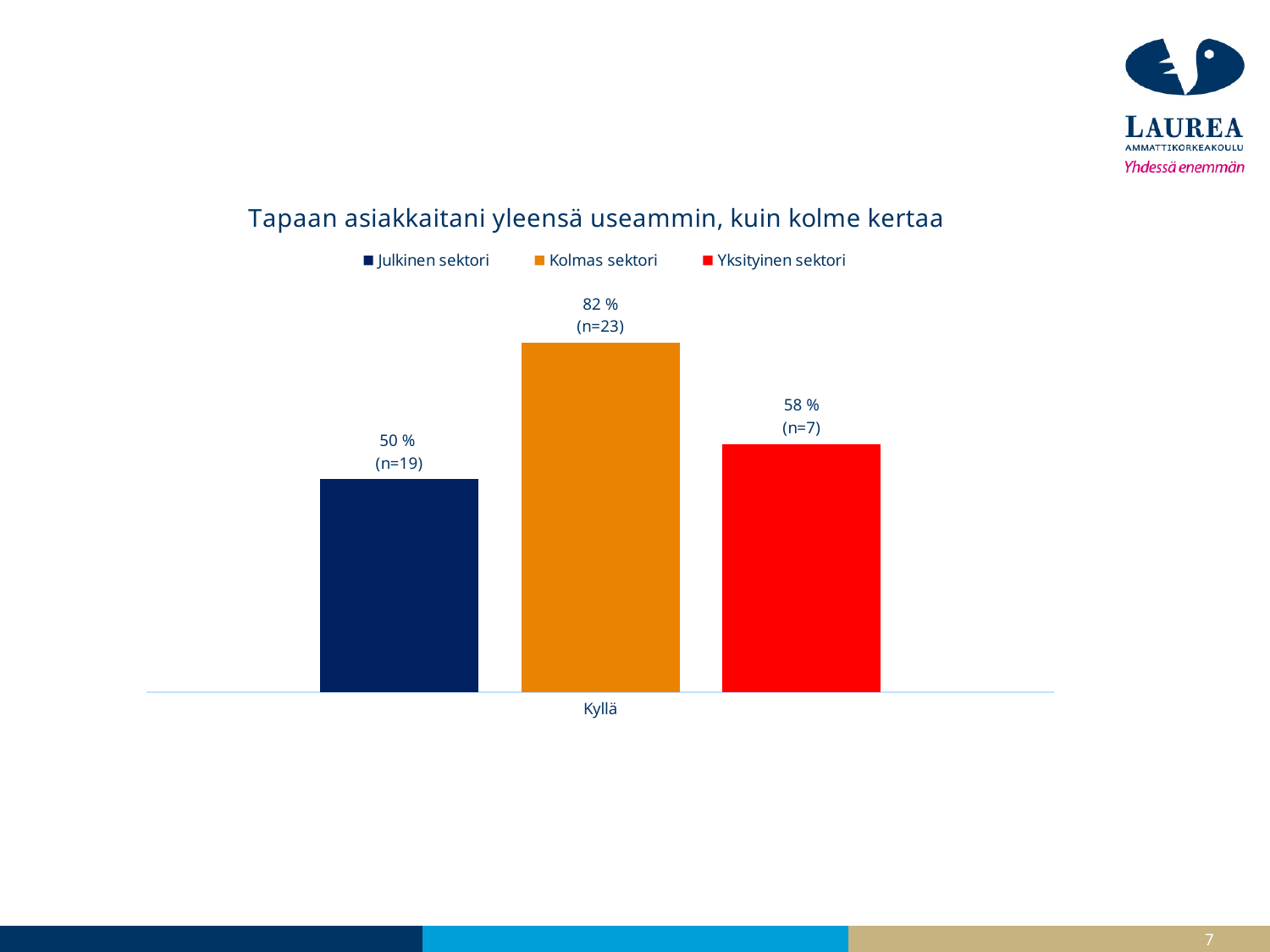
What is the difference between the values for Kolmas sektori and Julkinen sektori? 32 % What is the title of the chart? Tapaan asiakkaitani yleensä useammin, kuin kolme kertaa What is the n for Kolmas sektori? n=23 How many series does the legend list? 3 What is the n for Julkinen sektori? n=19 What is the value for Kolmas sektori? 82 % Which series has the highest value? Kolmas sektori What kind of chart is shown? Bar chart Which series has the lowest value? Julkinen sektori What is the value for Yksityinen sektori? 58 % Which is larger, the value for Yksityinen sektori or Julkinen sektori? Yksityinen sektori What is the value for Julkinen sektori? 50 %